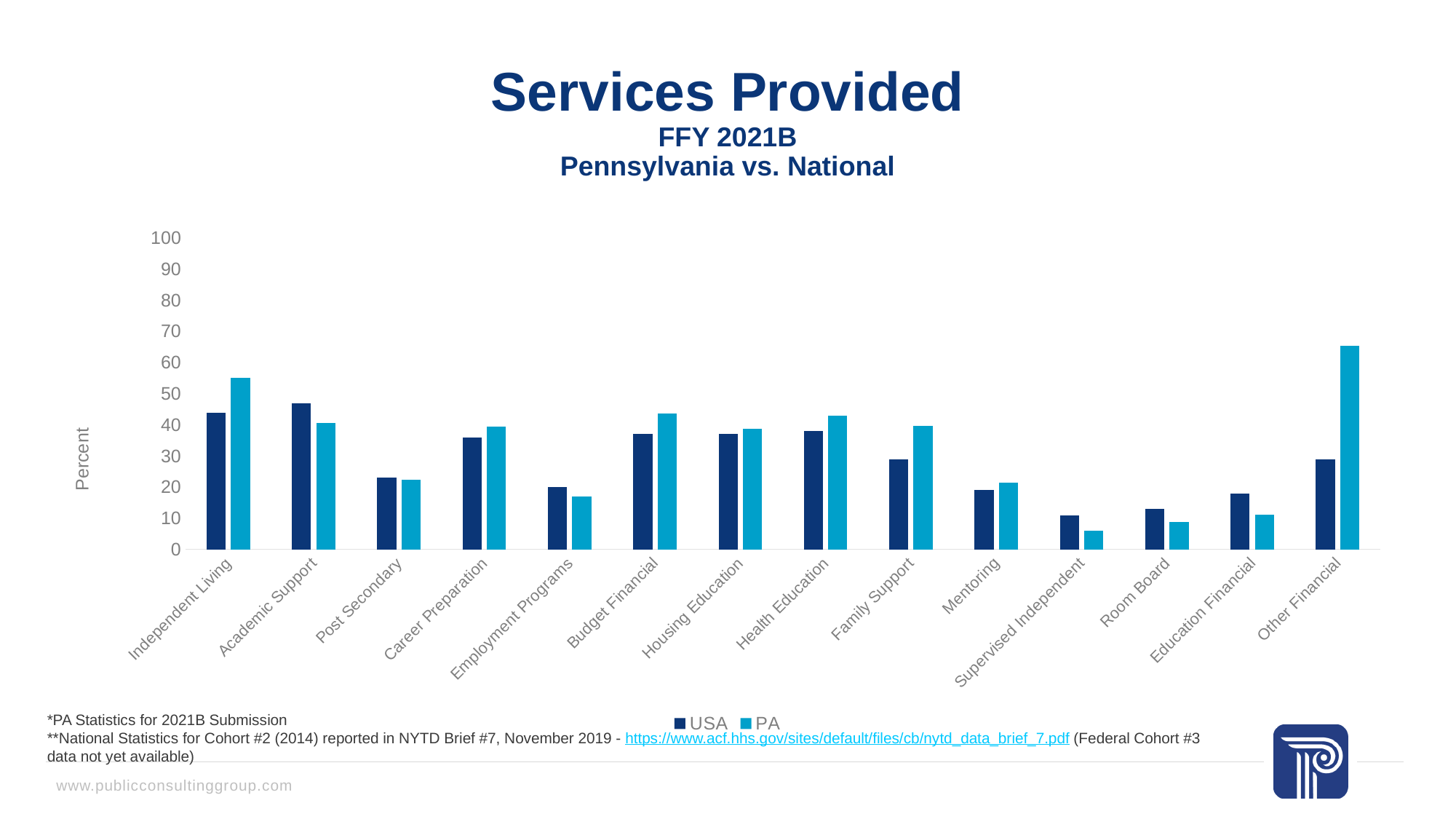
What is the label on the vertical axis? Percent For Academic Support, which is larger, the USA value or the PA value? USA How many service categories are shown on the x axis? 14 Is the PA value for Other Financial greater or less than 60? greater Is the PA value for Independent Living greater or less than 50? greater How many series does the legend list? 2 What kind of chart is shown on the slide? bar chart Which category has the highest PA value? Other Financial Is the PA value for Supervised Independent greater or less than 10? less For Family Support, which is larger, the USA value or the PA value? PA Which category has the lowest PA value? Supervised Independent